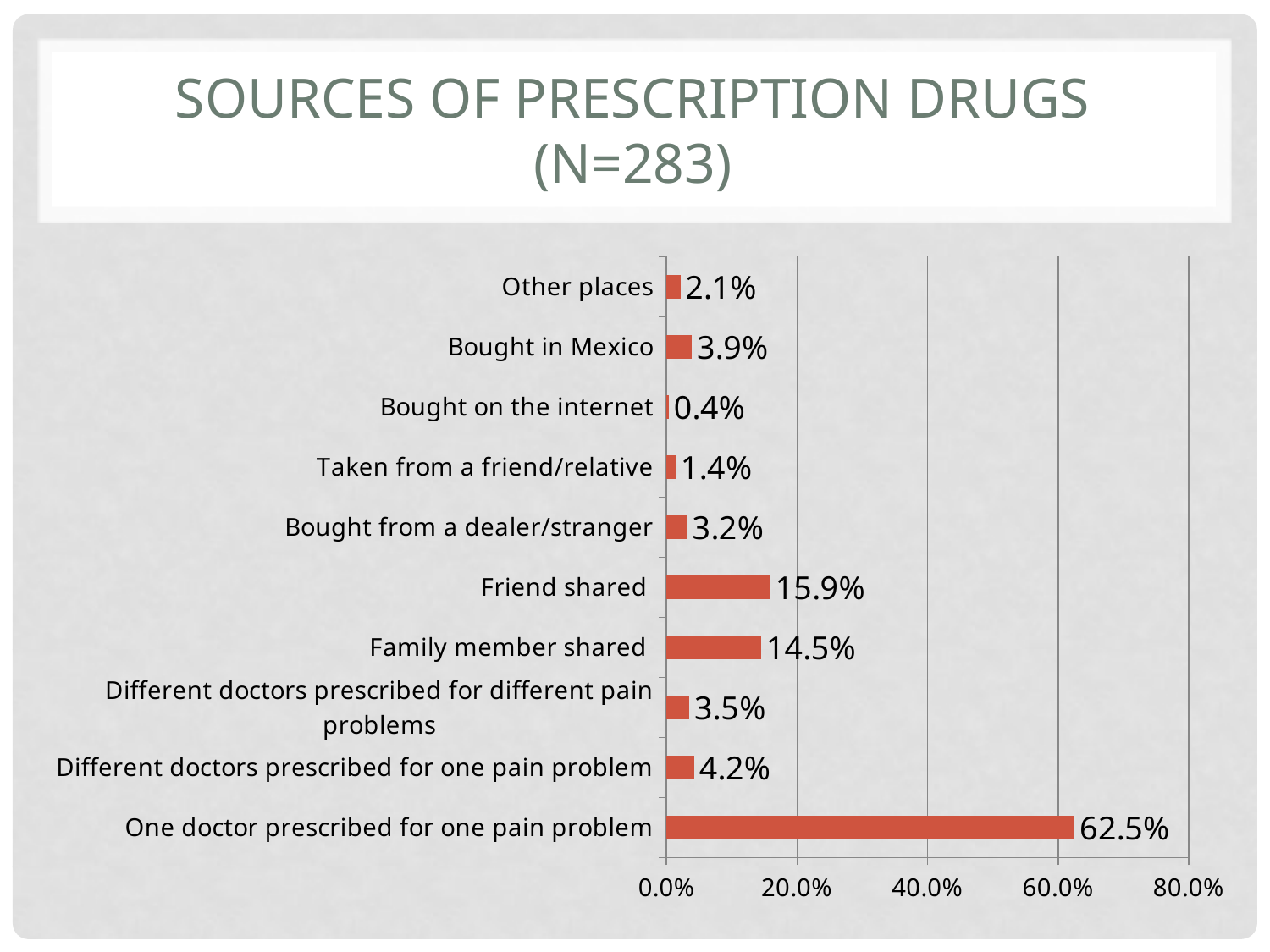
What percentage is shown for "One doctor prescribed for one pain problem"? 62.5% What percentage is shown for "Taken from a friend/relative"? 1.4% What kind of chart is shown on the slide? Bar chart How many source categories are shown in the chart? 10 What percentage is shown for "Bought in Mexico"? 3.9% Is the value for "One doctor prescribed for one pain problem" greater or less than 60.0%? greater Which source has the lowest percentage? Bought on the internet Which source has the highest percentage? One doctor prescribed for one pain problem What percentage is shown for "Friend shared"? 15.9% What is the sample size (N) given in the chart title? 283 Which is larger: "Different doctors prescribed for one pain problem" or "Different doctors prescribed for different pain problems"? Different doctors prescribed for one pain problem What is the difference between "Friend shared" and "Family member shared"? 1.4%